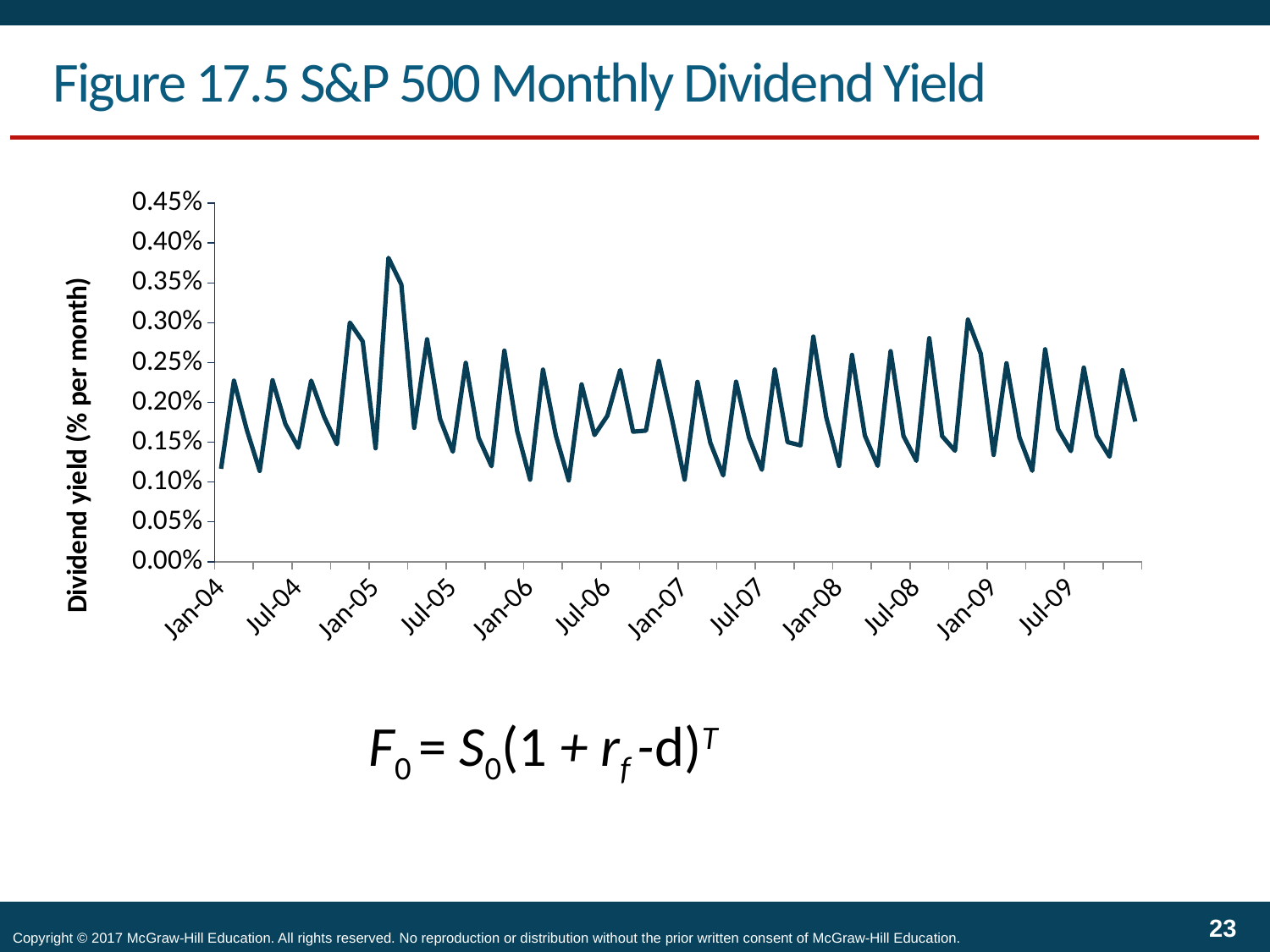
What is the last date label on the horizontal axis? Jul-09 What is the title of the chart on the slide? Figure 17.5 S&P 500 Monthly Dividend Yield Is the value for Jan-04 greater or less than 0.15%? less Is the peak value in early 2005 larger or smaller than the peak value in early 2009? larger What is the maximum value shown on the vertical axis? 0.45% Is the highest value on the chart greater or less than 0.35%? greater Is the lowest value on the chart greater or less than 0.15%? less What kind of chart is shown on the slide? Line chart What is the label on the vertical axis of the chart? Dividend yield (% per month) What is the first date label on the horizontal axis? Jan-04 In which year does the chart reach its highest dividend yield? 2005